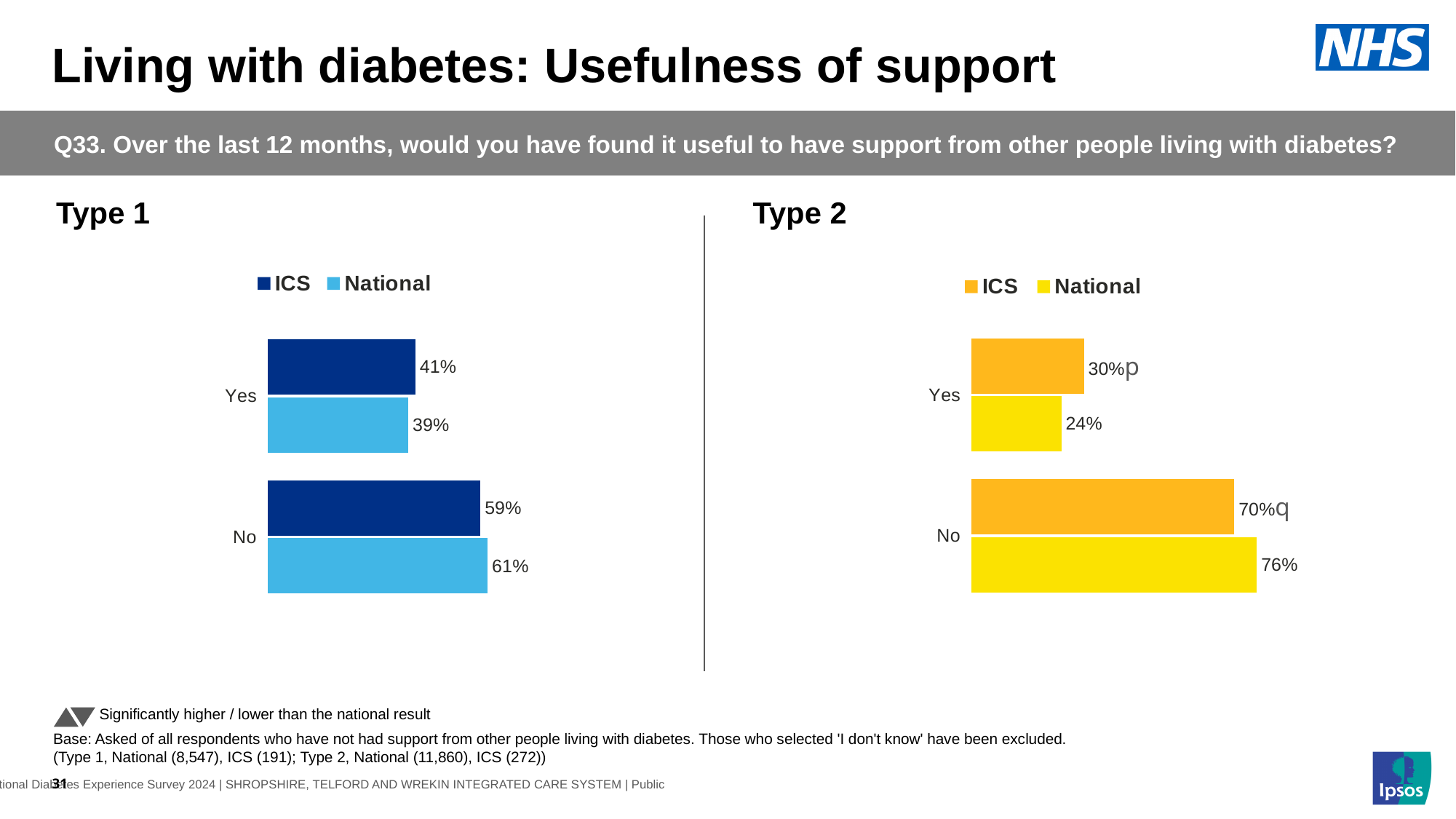
In the Type 1 chart, which is larger for No, the ICS value or the National value? National How many series does the legend of the Type 1 chart list? 2 In the Type 1 chart, what is the difference between the ICS and National values for Yes? 2% In the Type 2 chart, what is the National value for No? 76% In the Type 2 chart, what is the ICS value for Yes? 30% In the Type 1 chart, what is the National value for No? 61% In the Type 1 chart, what is the ICS value for Yes? 41% How many categories are shown in the Type 2 chart? 2 What kind of chart is the Type 1 chart? Bar chart In the Type 2 chart, what is the difference between the National and ICS values for No? 6% In the Type 2 chart, which is larger for Yes, the ICS value or the National value? ICS In the Type 2 chart, which category has the highest ICS value? No